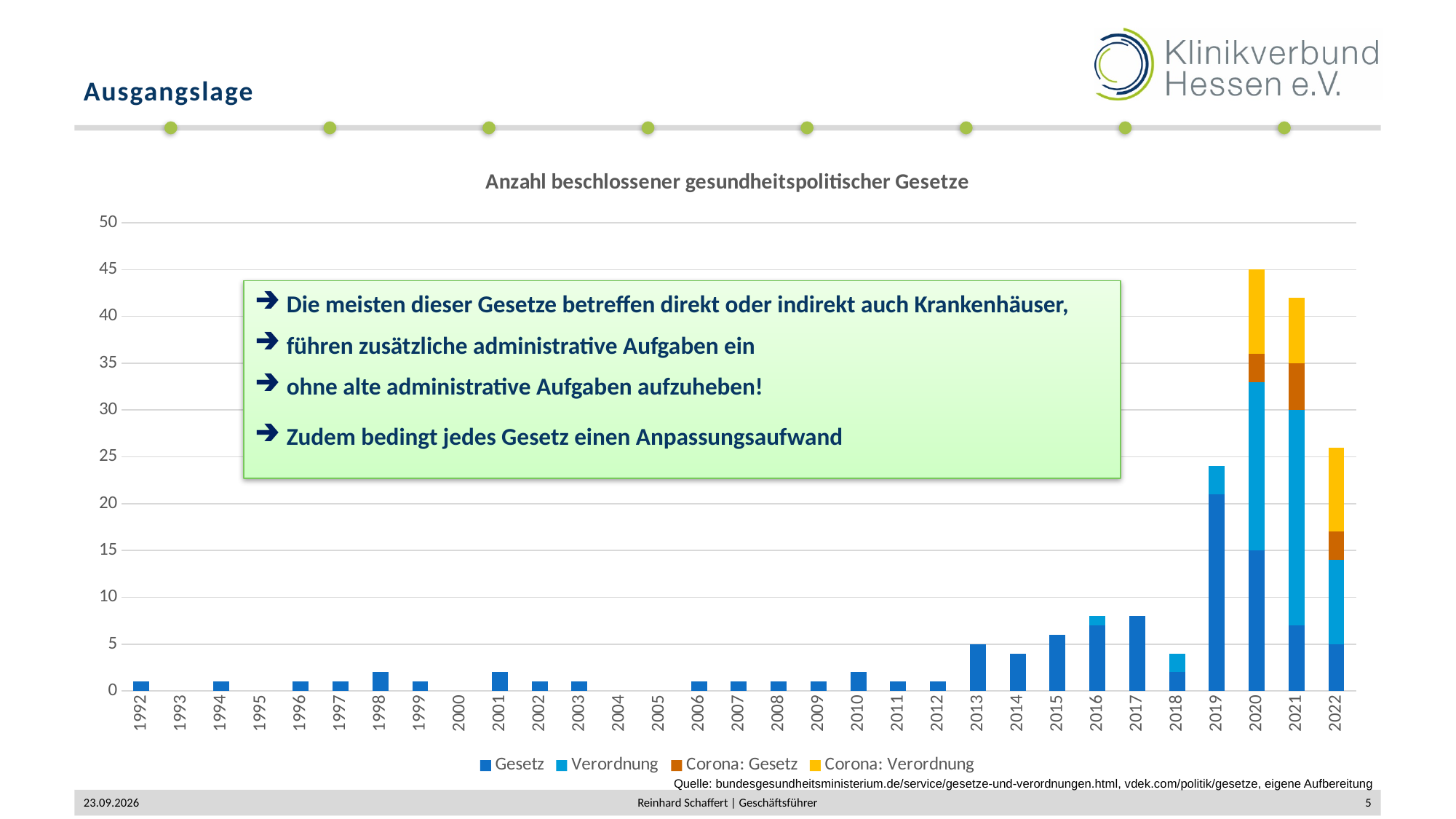
Is the total value for 2019 greater or less than 20? greater Is the total value for 2021 greater or less than 40? greater What is the title of the chart? Anzahl beschlossener gesundheitspolitischer Gesetze How many series does the legend list? 4 Which legend entry is shown in yellow? Corona: Verordnung What is the value of the bar for 2013? 5 What is the total value of the bar for 2020? 45 What kind of chart is shown on the slide? Stacked bar chart How many years are shown on the x axis? 31 Which year has the highest total bar? 2020 Is the value for 2017 greater or less than 10? less Which year has the larger total bar, 2019 or 2020? 2020